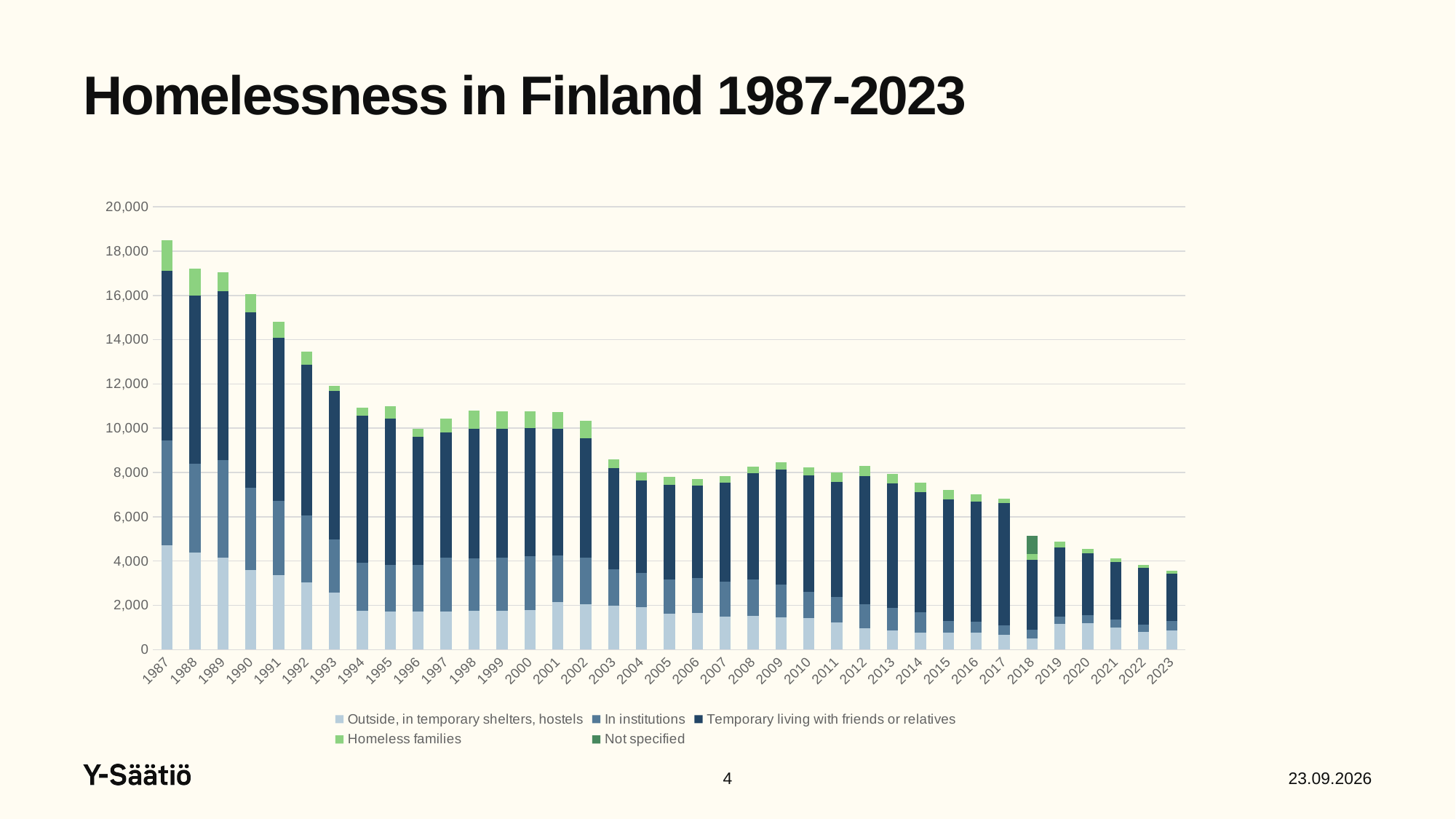
What is the title of the chart? Homelessness in Finland 1987-2023 Is the total for 1987 greater or less than 18,000? greater Which year has the larger total bar, 1990 or 2000? 1990 Is the total for 2023 greater or less than 4,000? less Which is the only year with a 'Not specified' segment in its bar? 2018 Which year has the shortest total bar? 2023 How many series does the legend list? 5 What kind of chart is shown on the slide? Stacked bar chart Do the total bar heights generally rise or fall from 1987 to 2023? Fall Which year has the tallest total bar? 1987 How many years (bars) are shown on the x axis? 37 Is the total for 1992 greater or less than 12,000? greater